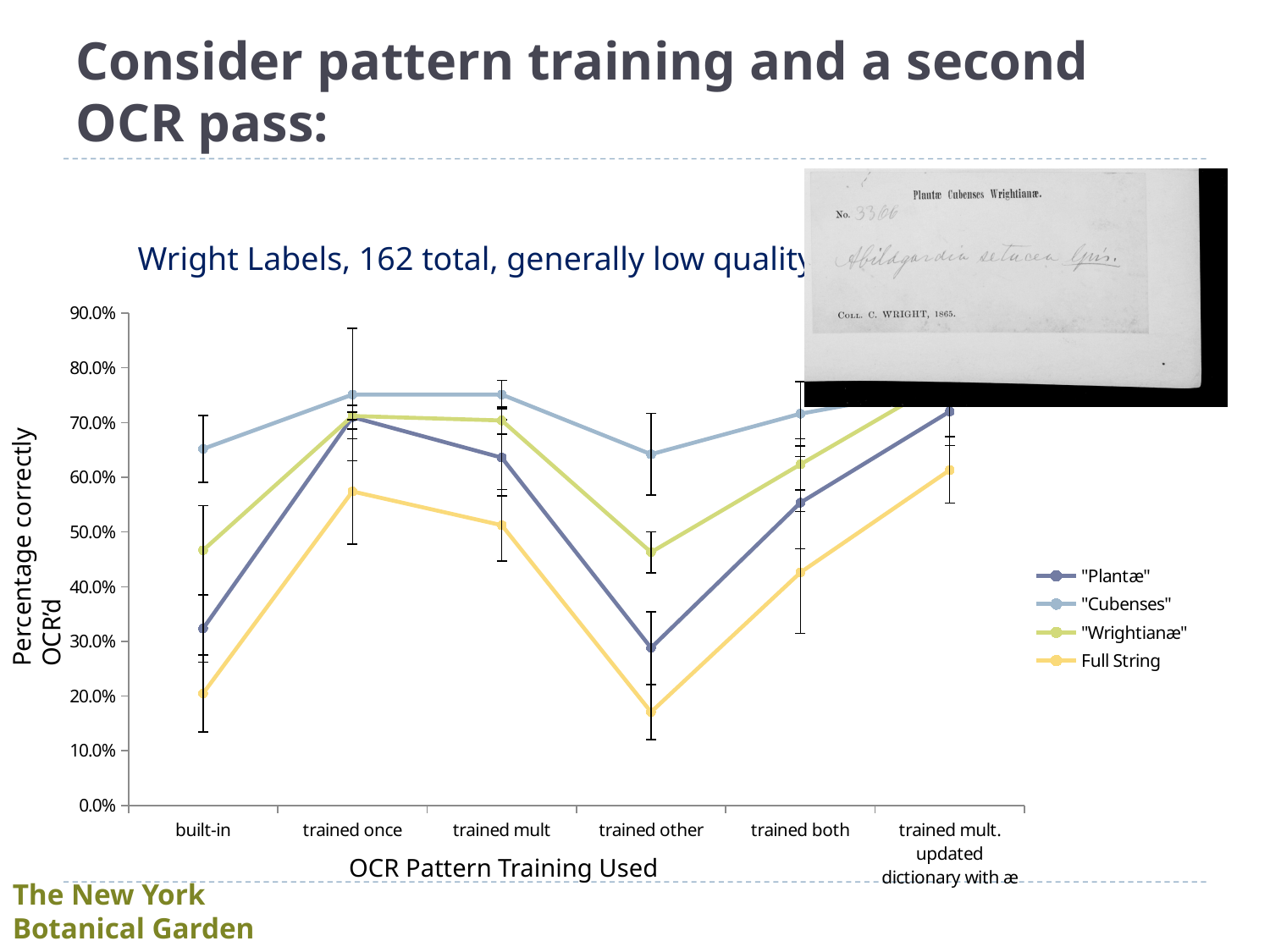
Is the "Plantæ" value for trained other greater or less than 40.0%? less What kind of chart is shown on the slide? line chart How many categories are shown along the x axis? 6 Which series has the lowest value at trained both? Full String Is the "Cubenses" value for built-in greater or less than 60.0%? greater Which series has the highest value at built-in? "Cubenses" At trained other, which is larger: the "Plantæ" value or the "Wrightianæ" value? "Wrightianæ" Is the Full String value for trained once greater or less than 50.0%? greater How many series does the legend list? 4 What is the title of the chart? Wright Labels, 162 total, generally low quality For the Full String series, which category has the lowest value? trained other